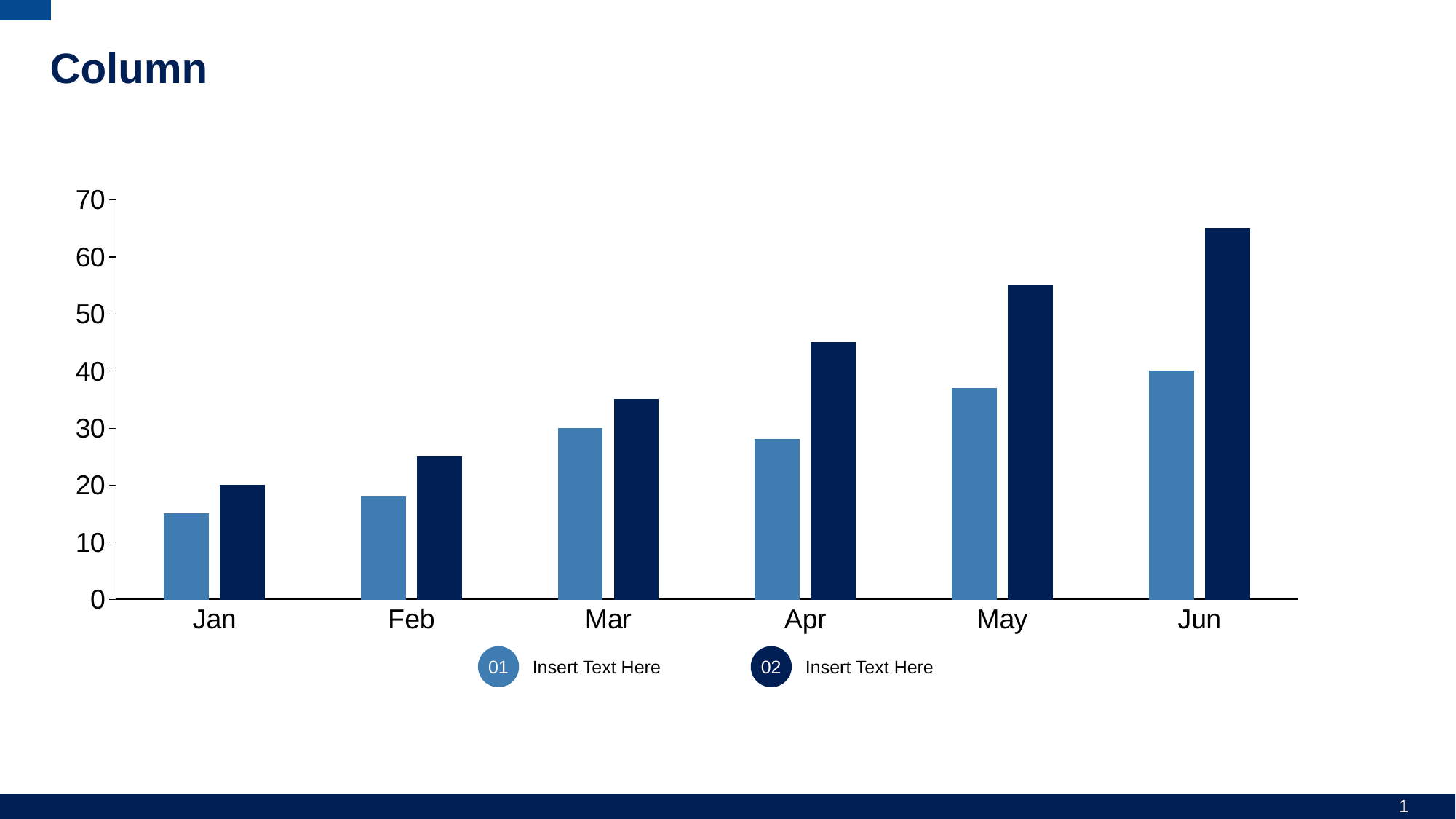
What is the title of the slide containing the chart? Column How many series does the chart's legend list? 2 Do the values of the dark blue series (02) rise or fall from Jan to Jun? rise What is the value of the dark blue series (02) for Jan? 20 Is the value of the dark blue series (02) for May greater or less than 50? greater What kind of chart is shown on the slide? bar chart In which month is the dark blue series (02) highest? Jun Is the value of the dark blue series (02) for Jun greater or less than 60? greater In which month is the light blue series (01) lowest? Jan Is the value of the light blue series (01) for Apr greater or less than 30? less For Jun, which series has the larger value, the light blue series (01) or the dark blue series (02)? dark blue series (02) How many months are shown on the x axis of the chart? 6